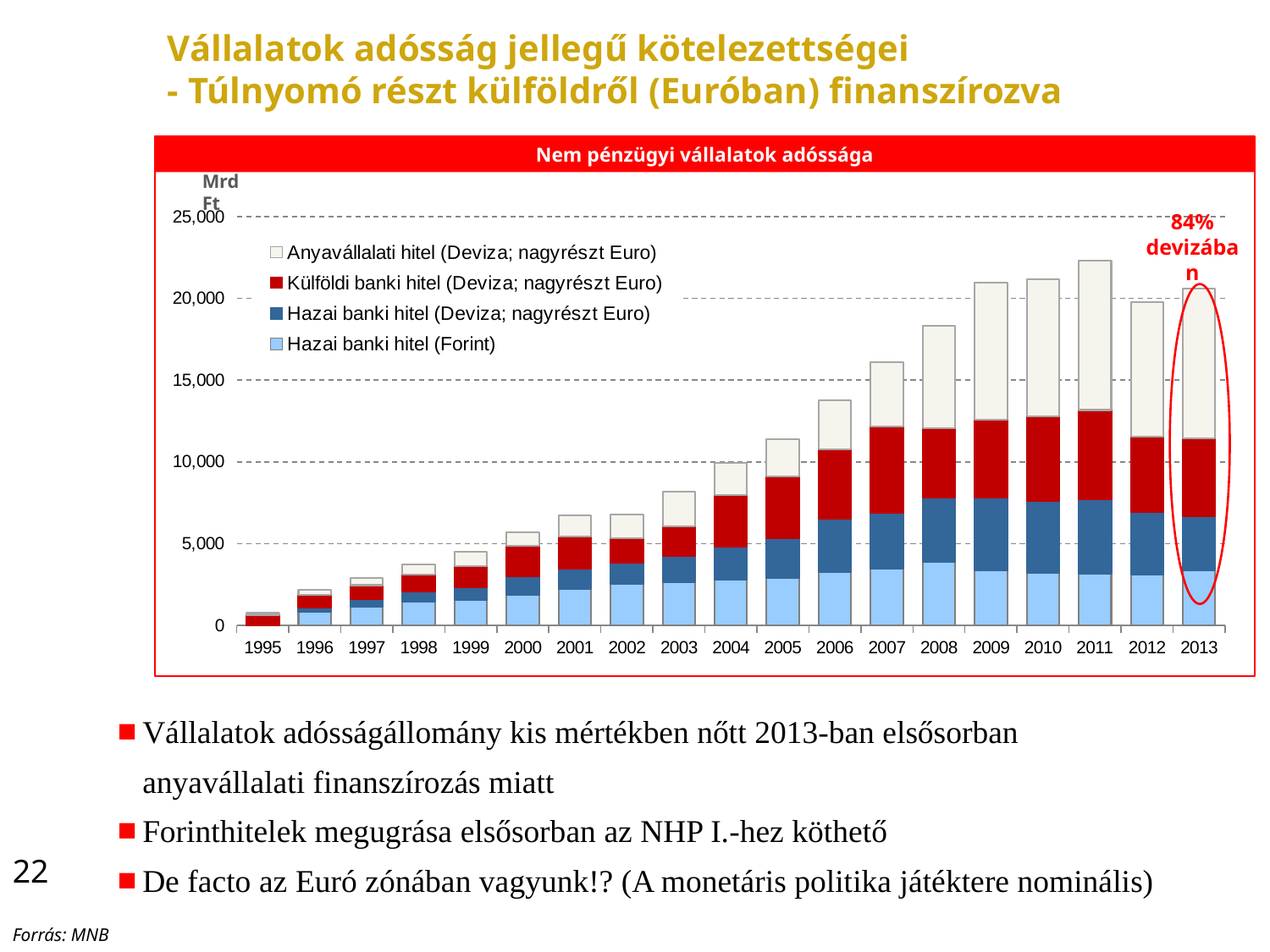
Is the total value for 1995 greater or less than 5,000? less Which year has the highest total stacked bar? 2011 How many years are shown on the x axis of the chart? 19 How many series does the legend of the chart list? 4 Which legend entry is shown in light blue? Hazai banki hitel (Forint) Is the total value for 2011 greater or less than 20,000? greater Is the total value for 2003 greater or less than 10,000? less Which year has the lowest total stacked bar? 1995 Do the total stacked bar values generally rise or fall from 1995 to 2011? rise What kind of chart is shown on the slide? Stacked bar chart What is the title of the chart? Nem pénzügyi vállalatok adóssága